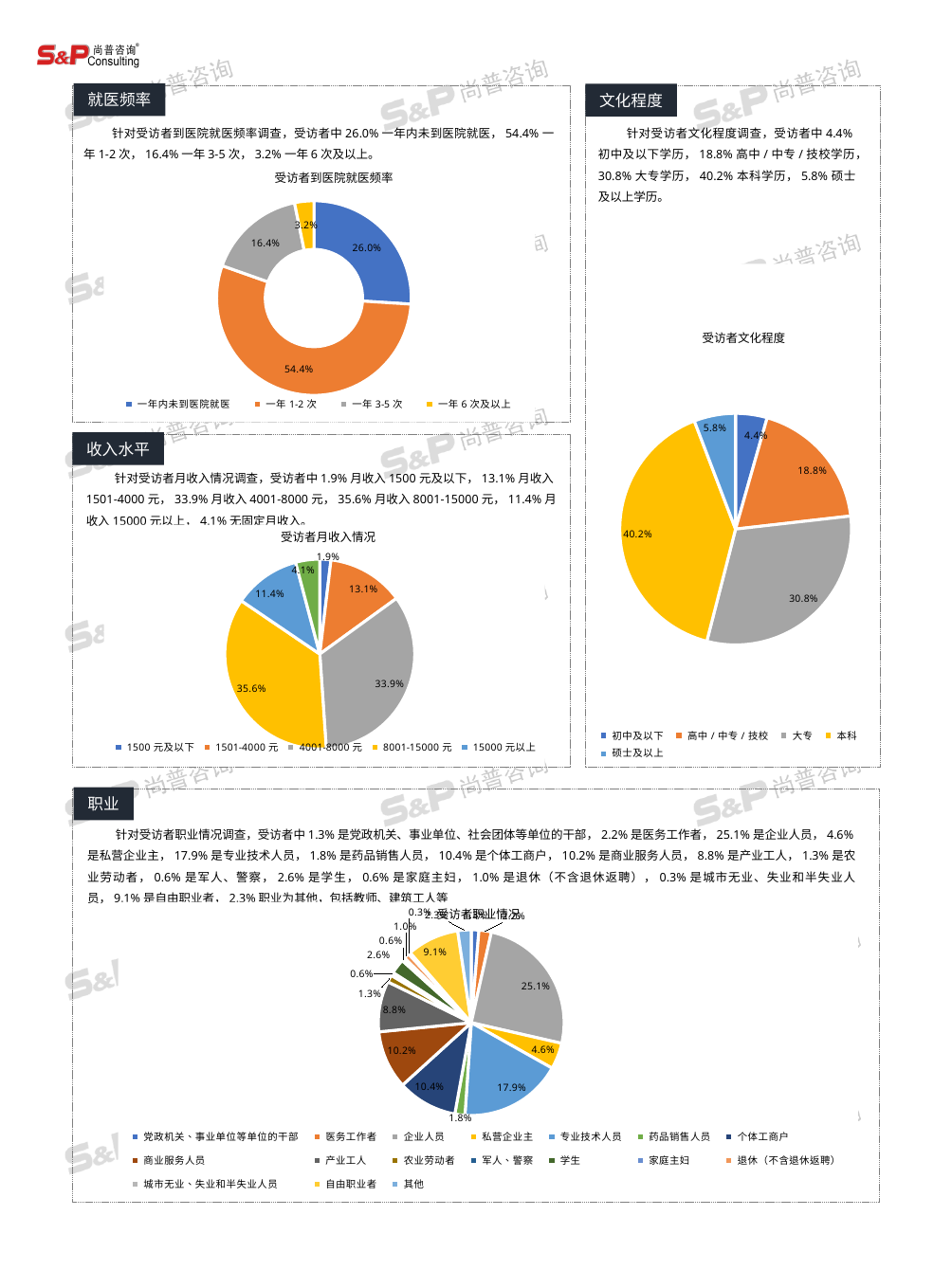
In the 受访者职业情况 chart, what is the difference between the 专业技术人员 share and the 个体工商户 share? 7.5% In the 受访者职业情况 chart, what share of respondents are 企业人员? 25.1% In the 受访者文化程度 chart, what is the difference between the 大专 share and the 高中 / 中专 / 技校 share? 12.0% In the 受访者到医院就医频率 chart, what share of respondents visited the hospital 1-2 times a year (一年 1-2 次)? 54.4% In the 受访者月收入情况 chart, which is larger: the share for 4001-8000 元 or the share for 1501-4000 元? 4001-8000 元 In the 受访者月收入情况 chart, which category has the smallest share? 1500 元及以下 In the 受访者文化程度 chart, which category has the largest share? 本科 In the 受访者文化程度 chart, what share of respondents have a 本科 degree? 40.2% In the 受访者到医院就医频率 chart, how many categories does the legend list? 4 In the 受访者月收入情况 chart, what share of respondents earn 8001-15000 元 per month? 35.6% In the 受访者到医院就医频率 chart, which category has the smallest share? 一年 6 次及以上 What kind of chart is the 受访者到医院就医频率 chart? Donut chart